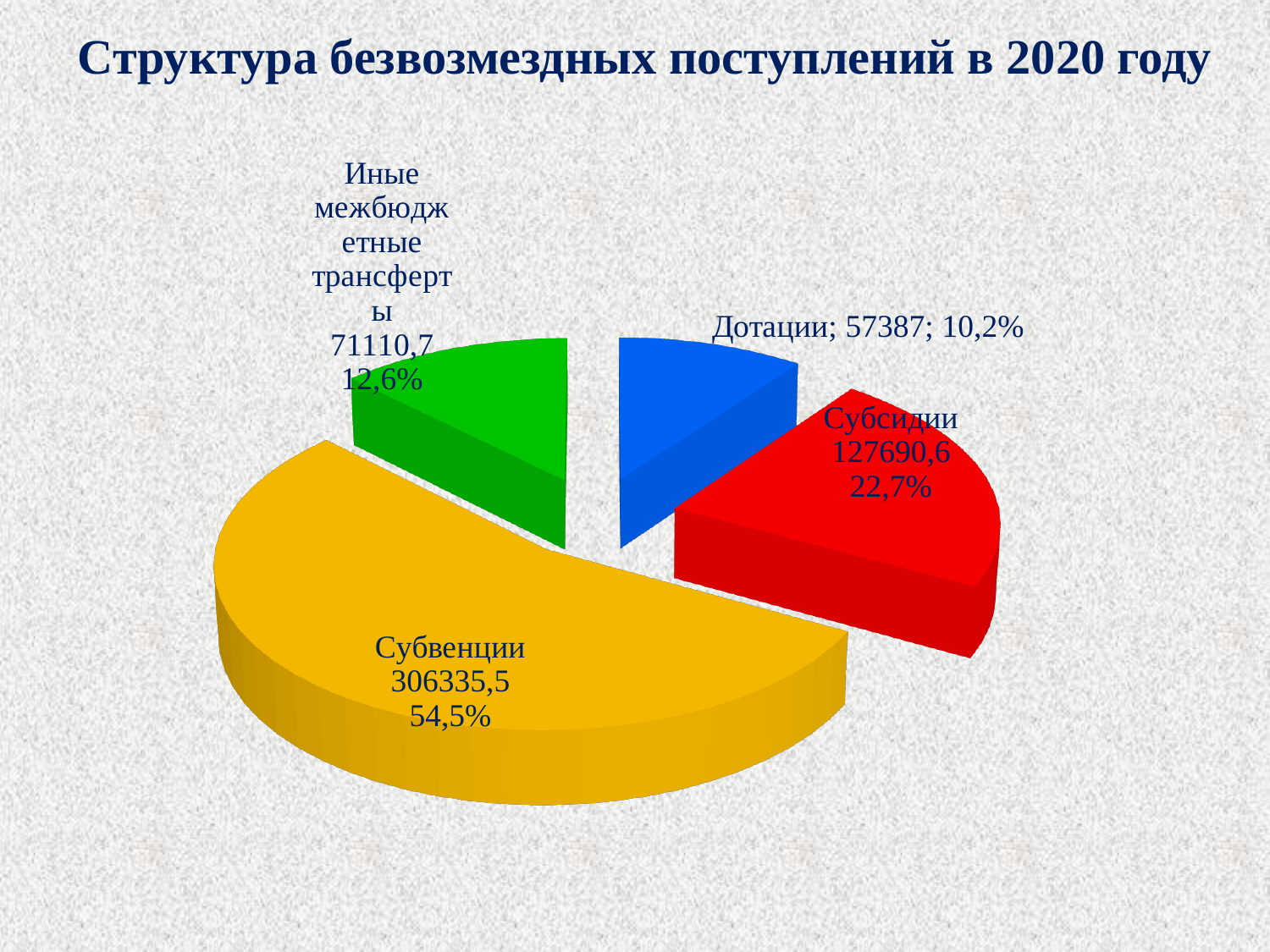
What is the title of the chart? Структура безвозмездных поступлений в 2020 году What is the value for Субсидии? 127690,6 What is the value for Иные межбюджетные трансферты? 71110,7 What is the value for Субвенции? 306335,5 What share of the pie does Дотации represent? 10,2% Which category has the largest slice? Субвенции What is the difference between the values for Субсидии and Дотации? 70303,6 What type of chart is shown on the slide? Pie chart How many slices does the pie chart have? 4 What is the value for Дотации? 57387 What share of the pie does Субвенции represent? 54,5% Which category has the smallest slice? Дотации